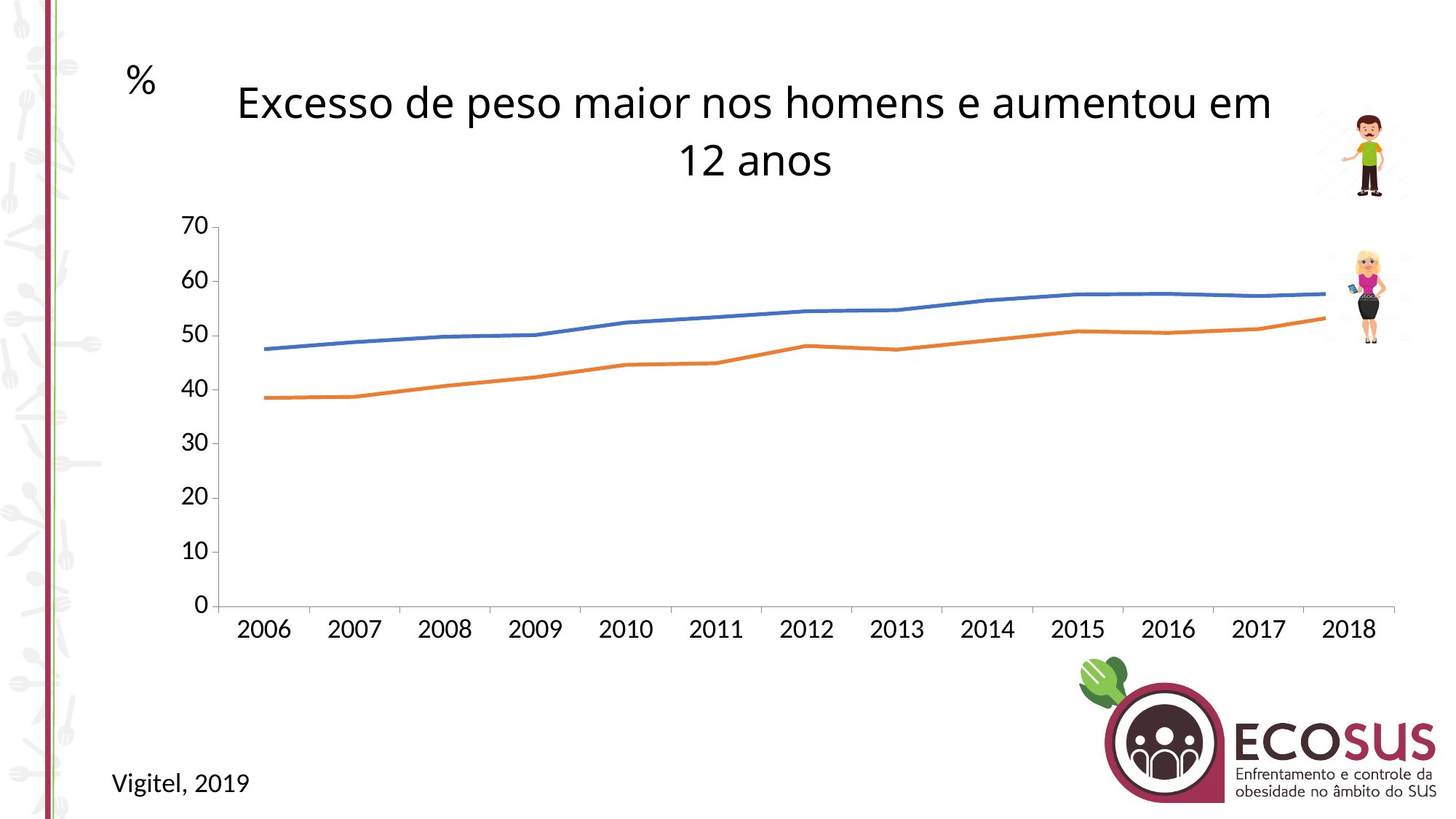
In which year does the blue line have its lowest value? 2006 Does the orange line rise or fall from 2006 to 2018? Rise How many years are shown along the x axis of the chart? 13 Is the value of the orange line in 2018 greater or less than 50? greater How many lines are plotted on the chart? 2 Is the value of the orange line in 2006 greater or less than 40? less Is the value of the blue line in 2006 greater or less than 50? less In 2010, which line has the higher value, the blue line or the orange line? Blue line What kind of chart is shown on the slide? Line chart What is the first year shown on the x axis? 2006 What is the title of the chart? Excesso de peso maior nos homens e aumentou em 12 anos Does the blue line rise or fall from 2006 to 2018? Rise